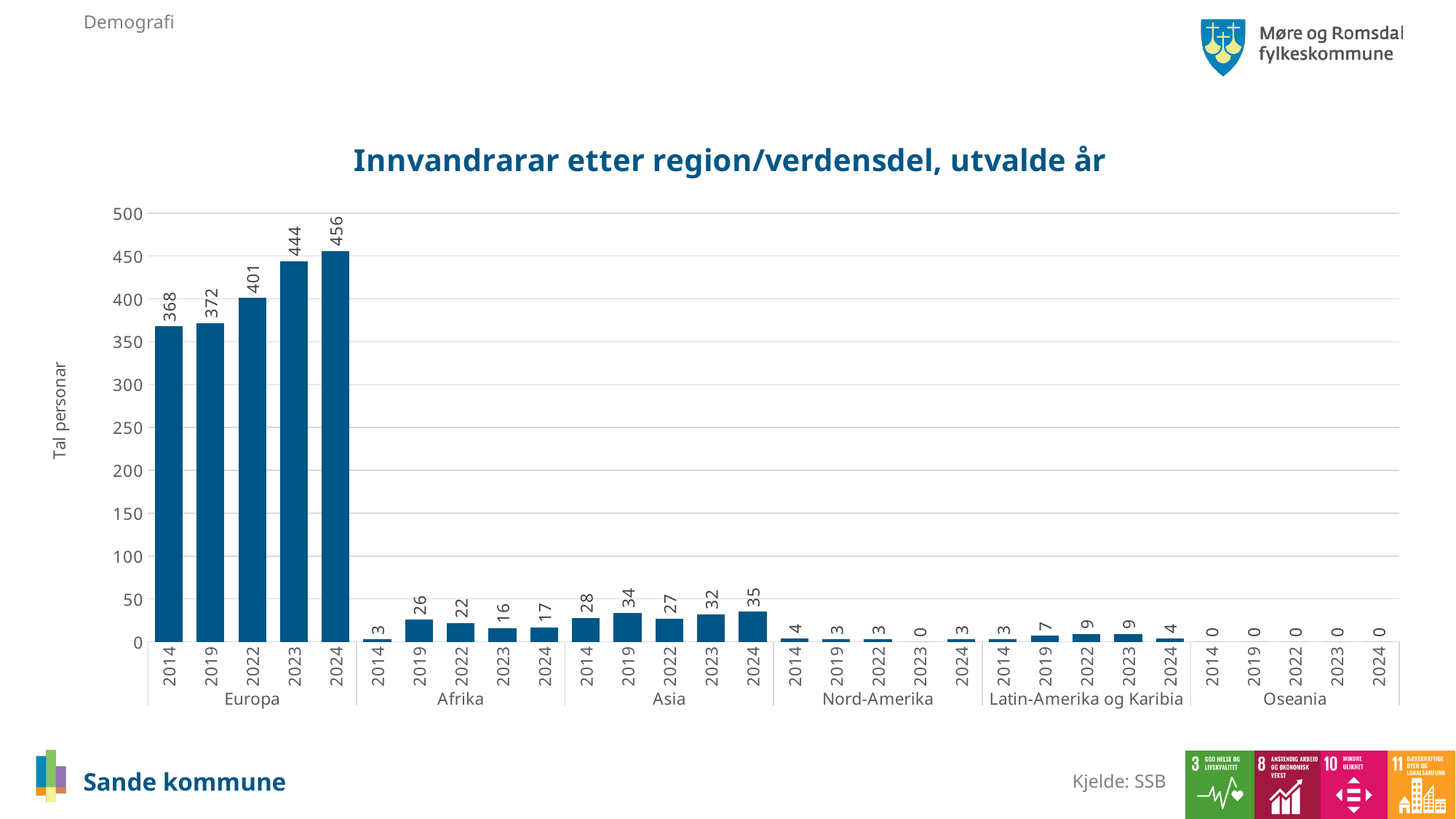
What is the difference between the Europa values for 2024 and 2014? 88 What is the value for Afrika in 2014? 3 What is the value for Asia in 2019? 34 Is the value for Europa in 2022 greater or less than 400? greater What type of chart is shown? bar chart Which region shows 0 for every year? Oseania Which is larger, the Afrika value for 2019 or the Asia value for 2019? Asia 2019 Do the Europa values rise or fall from 2014 to 2024? rise Which region has the highest bar in 2024? Europa How many regions are shown on the x axis? 6 What is the value for Latin-Amerika og Karibia in 2022? 9 What is the value for Europa in 2024? 456